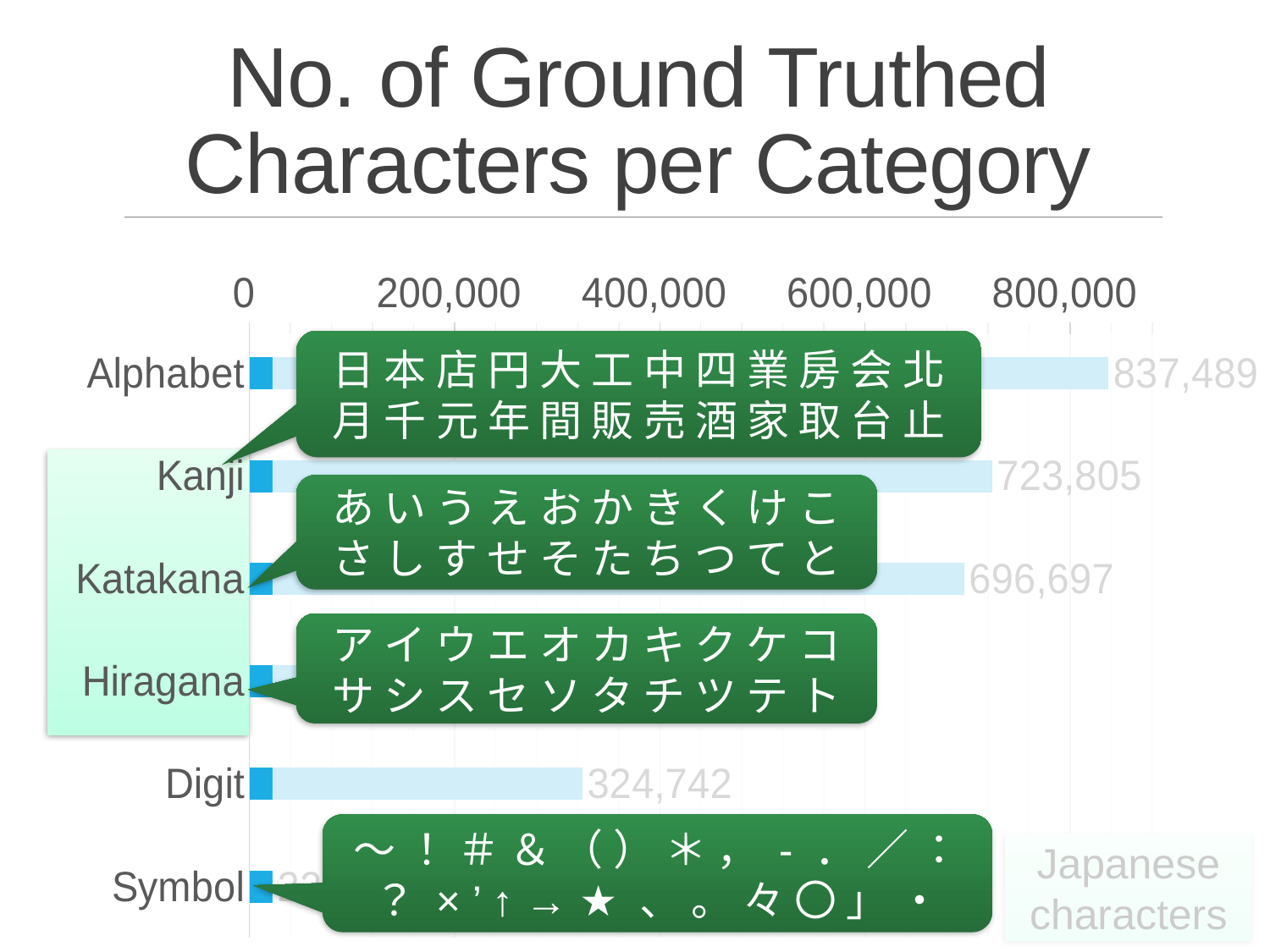
What is the number of ground truthed characters for Kanji? 723,805 What is the difference between the Alphabet and Kanji values? 113,684 What is the number of ground truthed characters for Digit? 324,742 Is the value for Digit greater or less than 400,000? less Which category has the highest number of ground truthed characters? Alphabet What is the difference between the Alphabet and Digit values? 512,747 What is the difference between the Kanji and Katakana values? 27,108 Which is larger, the value for Kanji or the value for Katakana? Kanji Which category has the lowest number of ground truthed characters? Symbol What is the number of ground truthed characters for Alphabet? 837,489 What is the number of ground truthed characters for Katakana? 696,697 How many categories are shown in the chart? 6